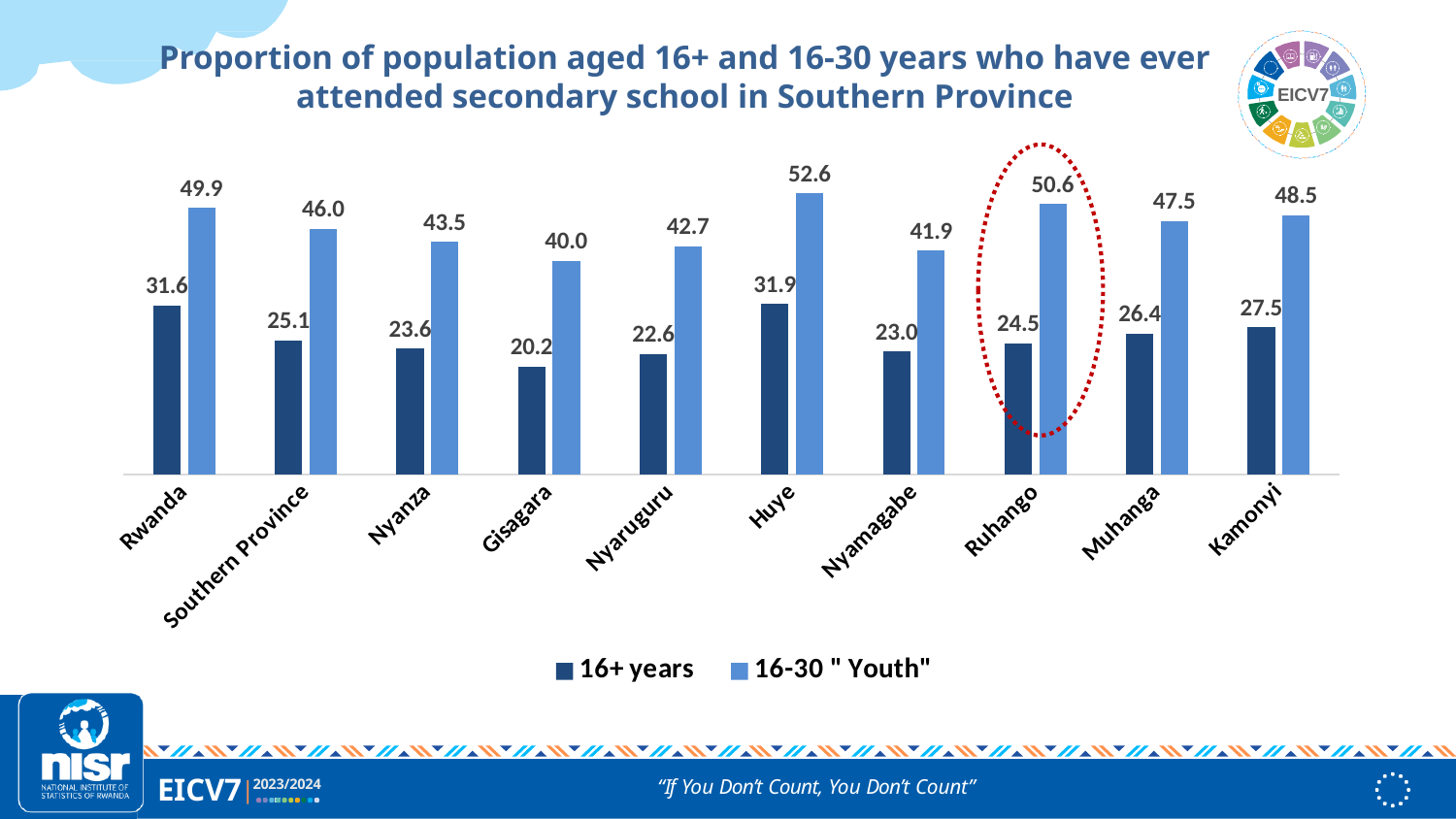
How many series does the legend list? 2 What is the value for the 16-30 "Youth" series in Huye? 52.6 What is the value for the 16+ years series in Gisagara? 20.2 What kind of chart is shown on the slide? Bar chart Which category has the lowest value for the 16+ years series? Gisagara What is the difference between the 16-30 "Youth" value and the 16+ years value in Ruhango? 26.1 Which is larger: the 16+ years value for Kamonyi or for Muhanga? Kamonyi Which category has the highest value for the 16-30 "Youth" series? Huye What is the value for the 16+ years series in Southern Province? 25.1 Which category is highlighted with a red dotted circle? Ruhango What is the value for the 16-30 "Youth" series in Ruhango? 50.6 How many categories are shown on the x axis? 10